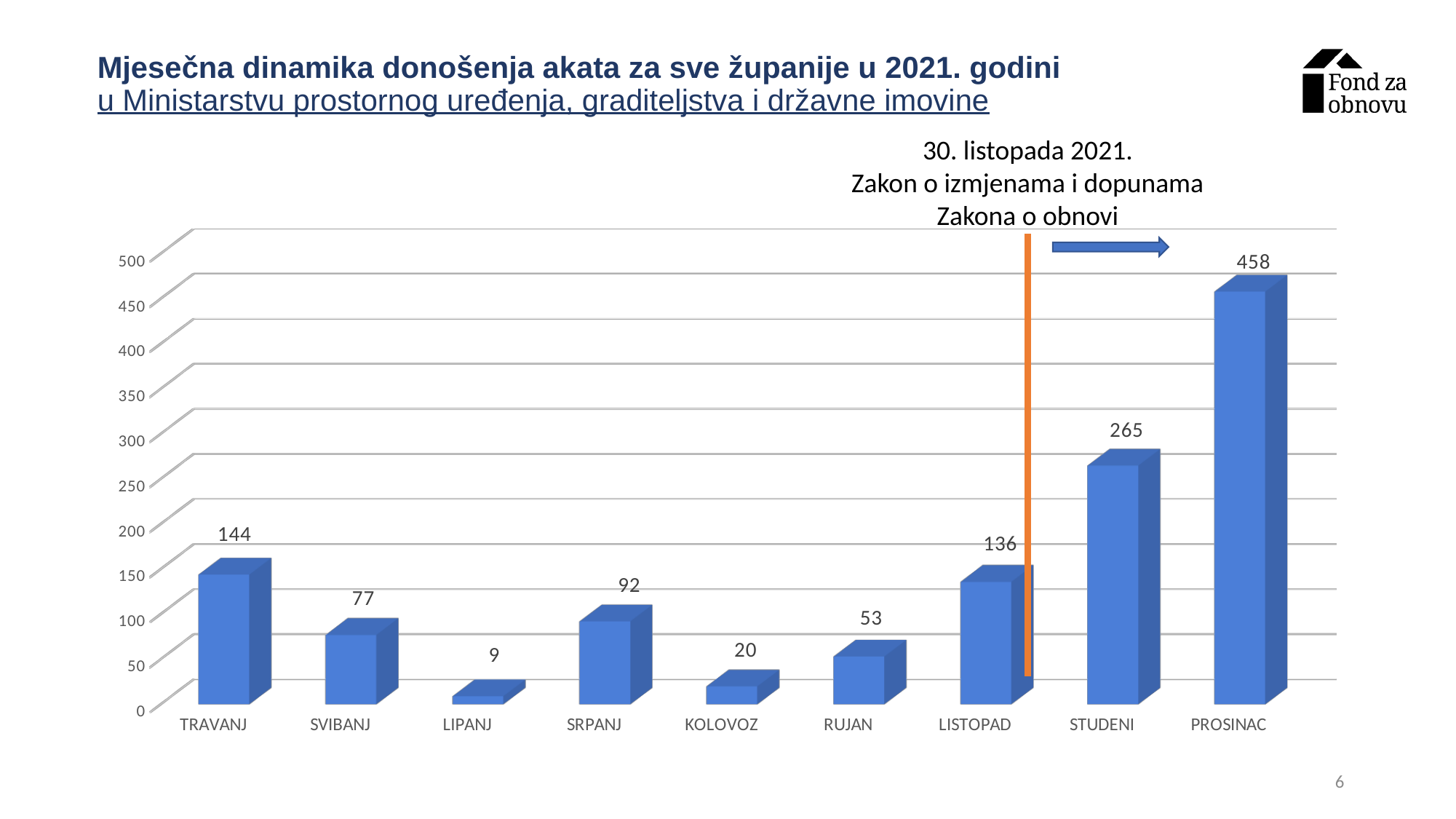
How many months are shown on the x axis? 9 What kind of chart is shown on the slide? bar chart What is the value for LIPANJ? 9 What is the value for TRAVANJ? 144 What is the value for LISTOPAD? 136 What is the difference between the values for PROSINAC and STUDENI? 193 Which month has the lowest value? LIPANJ Do the values rise or fall from LISTOPAD to PROSINAC? rise Which is larger, the value for SRPANJ or the value for SVIBANJ? SRPANJ Is the value for STUDENI greater or less than 250? greater Which month has the highest value? PROSINAC What date is written in the annotation above the chart? 30. listopada 2021.